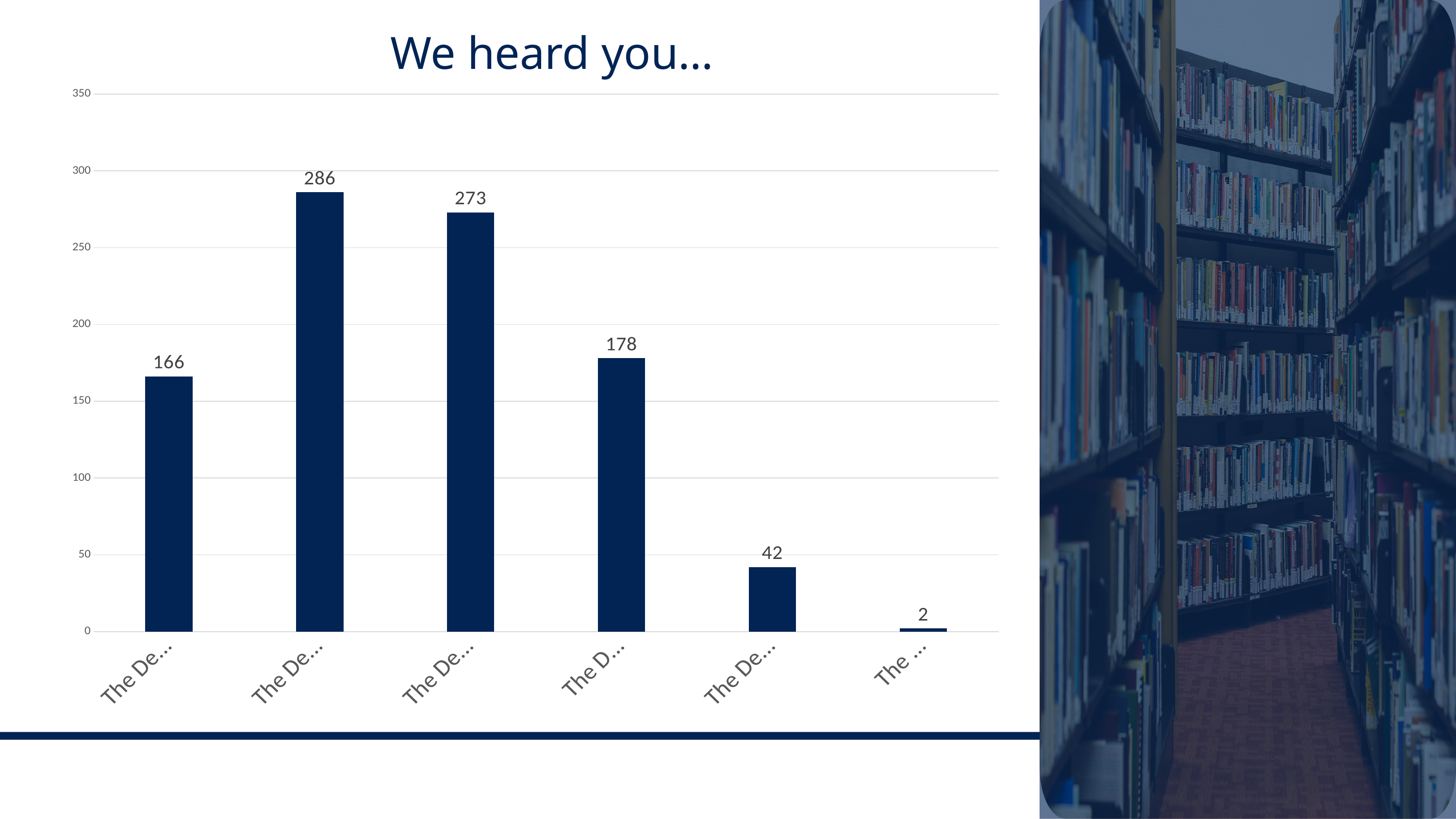
What is the difference between the fourth bar (178) and the fifth bar (42)? 136 What is the difference between the second bar (286) and the third bar (273)? 13 What is the value of the fourth bar from the left? 178 What is the value of the last (rightmost) bar? 2 What is the value of the first (leftmost) bar? 166 How many bars are plotted in the chart? 6 Which bar has the highest value? the second bar from the left (286) What is the title of the slide containing the chart? We heard you… What kind of chart is shown on the slide? bar chart Which bar has the lowest value? the rightmost bar (2) What is the value of the second bar from the left? 286 Which is larger, the first bar or the fourth bar? the fourth bar (178)